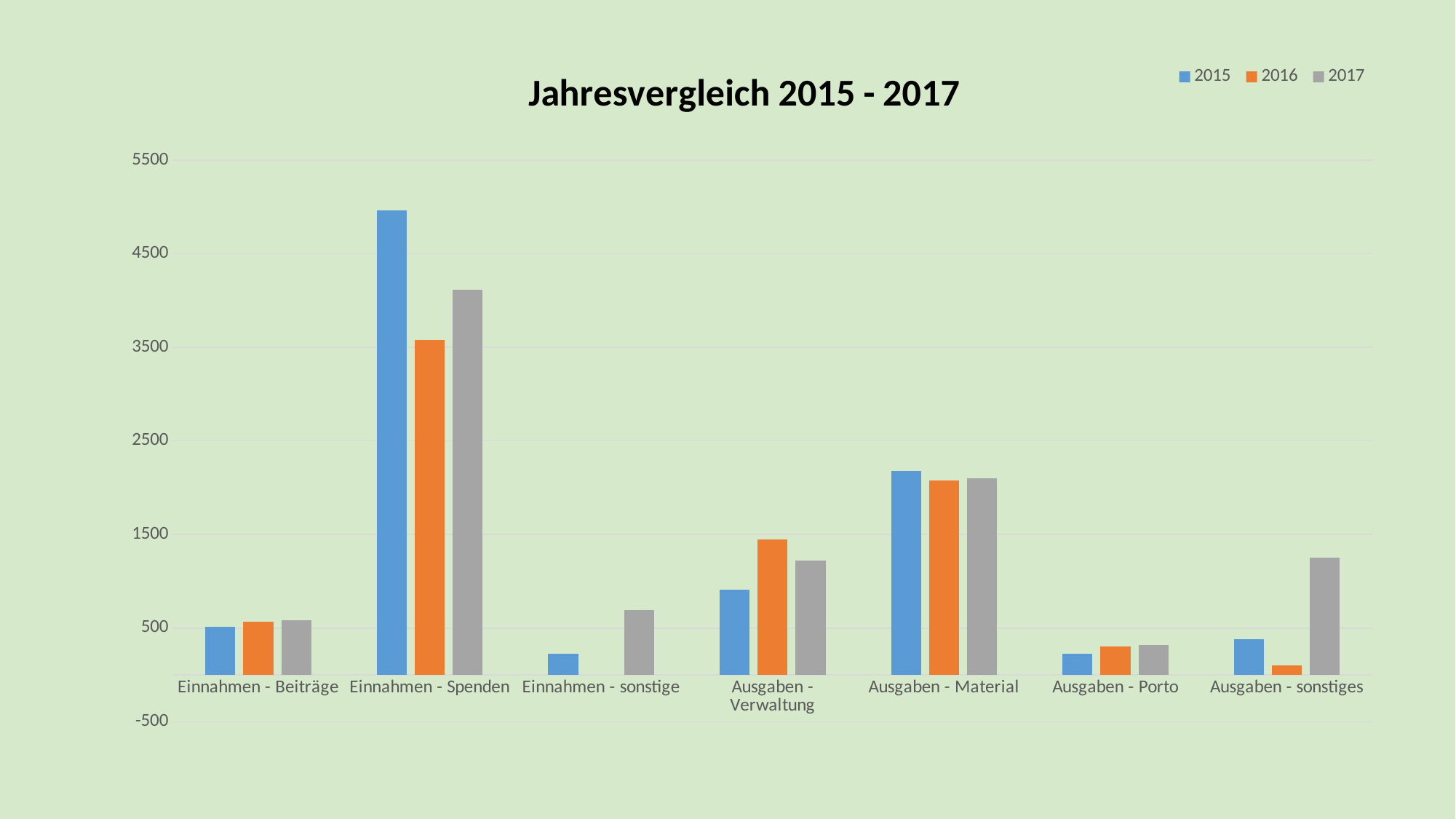
Is the 2017 value for Ausgaben - Verwaltung greater or less than 1500? less How many series does the legend list? 3 For Ausgaben - Verwaltung, which year has the larger value, 2015 or 2016? 2016 Which colour represents the 2016 series in the legend? orange Is the 2015 value for Einnahmen - Spenden greater or less than 4500? greater What is the title of the chart? Jahresvergleich 2015 - 2017 For Ausgaben - sonstiges, which year has the larger value, 2016 or 2017? 2017 Is the 2015 value for Ausgaben - Material greater or less than 1500? greater Which category has the highest 2015 bar? Einnahmen - Spenden What kind of chart is shown on the slide? bar chart How many categories are shown on the x axis? 7